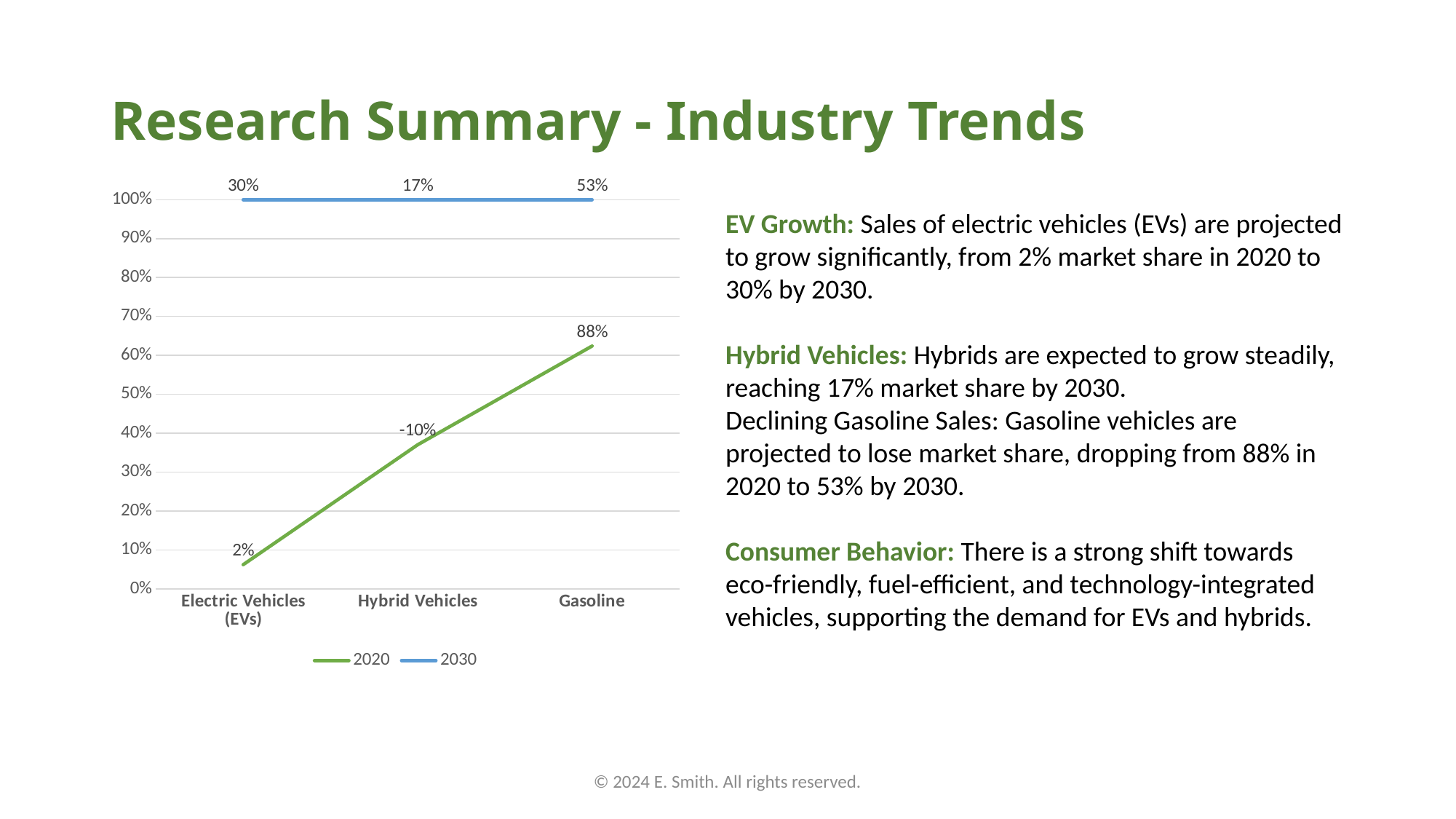
What is the data label for Electric Vehicles (EVs) in the 2020 series? 2% What kind of chart is shown on the slide? Line chart What is the difference between the Gasoline and Electric Vehicles (EVs) labels in the 2020 series? 86% What is the data label for Gasoline in the 2030 series? 53% What is the difference between the Gasoline and Electric Vehicles (EVs) labels in the 2030 series? 23% For Gasoline, which series has the larger labelled value, 2020 or 2030? 2020 What is the data label for Hybrid Vehicles in the 2030 series? 17% Which category has the highest labelled value in the 2020 series? Gasoline How many series does the chart legend list? 2 Which category has the lowest labelled value in the 2030 series? Hybrid Vehicles How many categories are shown on the x axis of the chart? 3 What is the data label for Hybrid Vehicles in the 2020 series? -10%